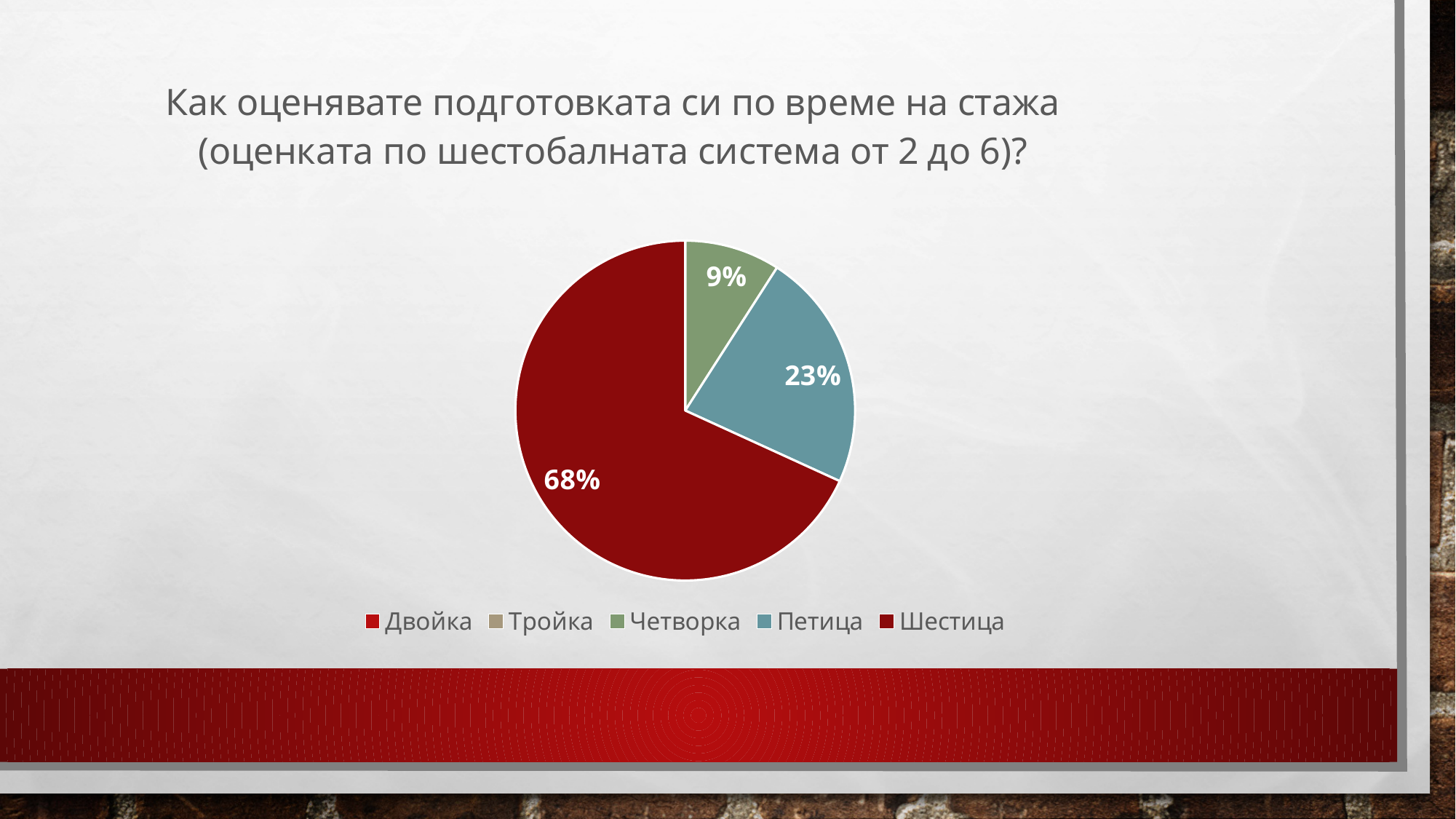
How many slices have a percentage label printed on the pie? 3 How many entries does the legend list? 5 What percentage of the pie chart is the Шестица slice? 68% What percentage is shown for the Петица slice? 23% What type of chart is shown on the slide? Pie chart What colour is the Петица slice in the pie chart? Teal (blue-green) Which category has the largest slice of the pie? Шестица What is the difference in percentage points between the Петица and Четворка slices? 14 What percentage is shown for the Четворка slice? 9% Which slice is larger, Петица or Четворка? Петица What is the difference in percentage points between the Шестица and Петица slices? 45 Which of the labelled slices is the smallest? Четворка